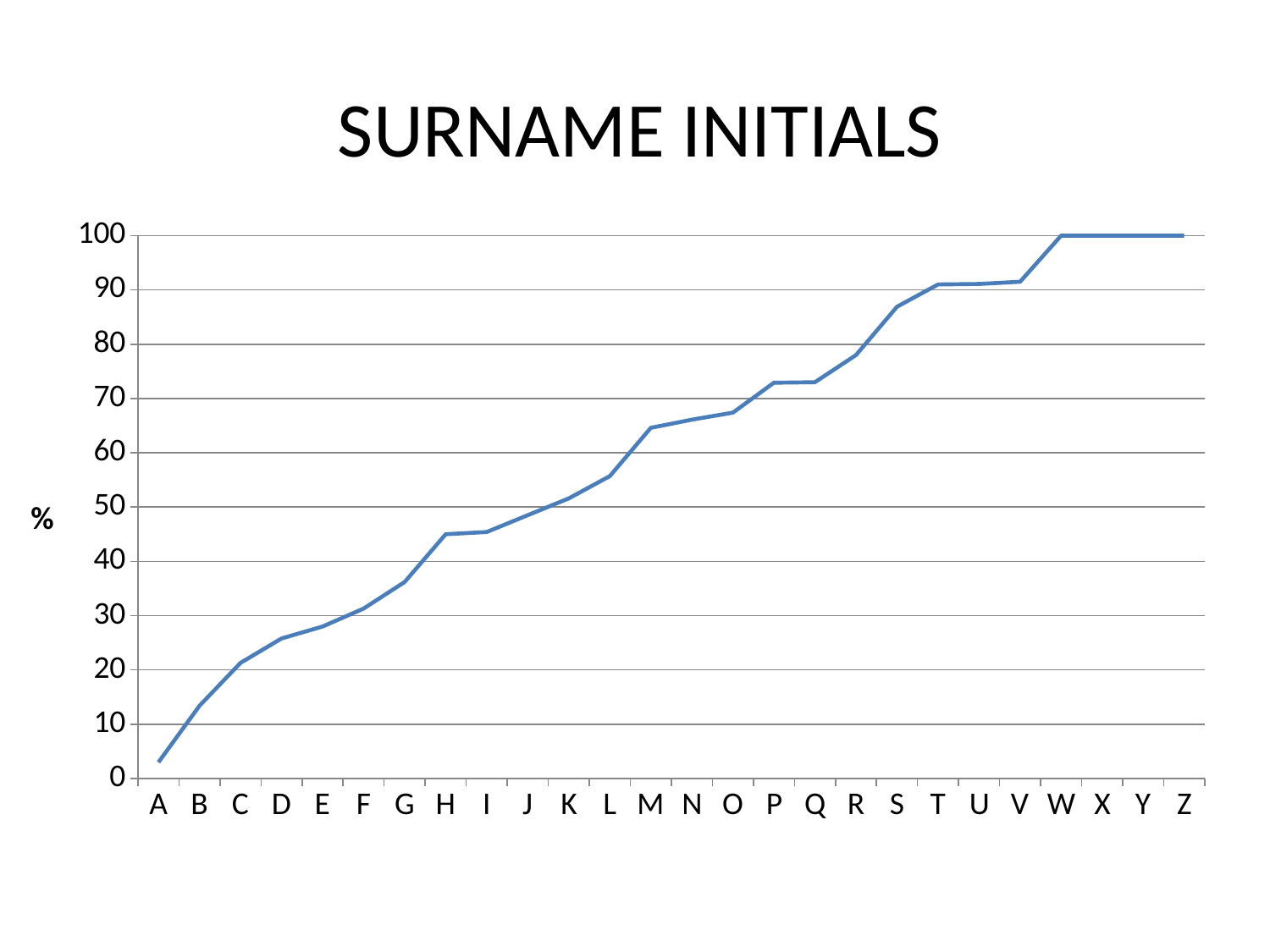
Is the value for M greater or less than 60? greater What is the label on the y axis? % What is the value for Z? 100 Which is larger, the value for M or the value for H? M Is the value for P greater or less than 70? greater Which category has the lowest value? A Is the value for G greater or less than 40? less Do the values rise or fall along the x axis from A to Z? rise How many categories are shown along the x axis? 26 What kind of chart is shown on the slide? line chart